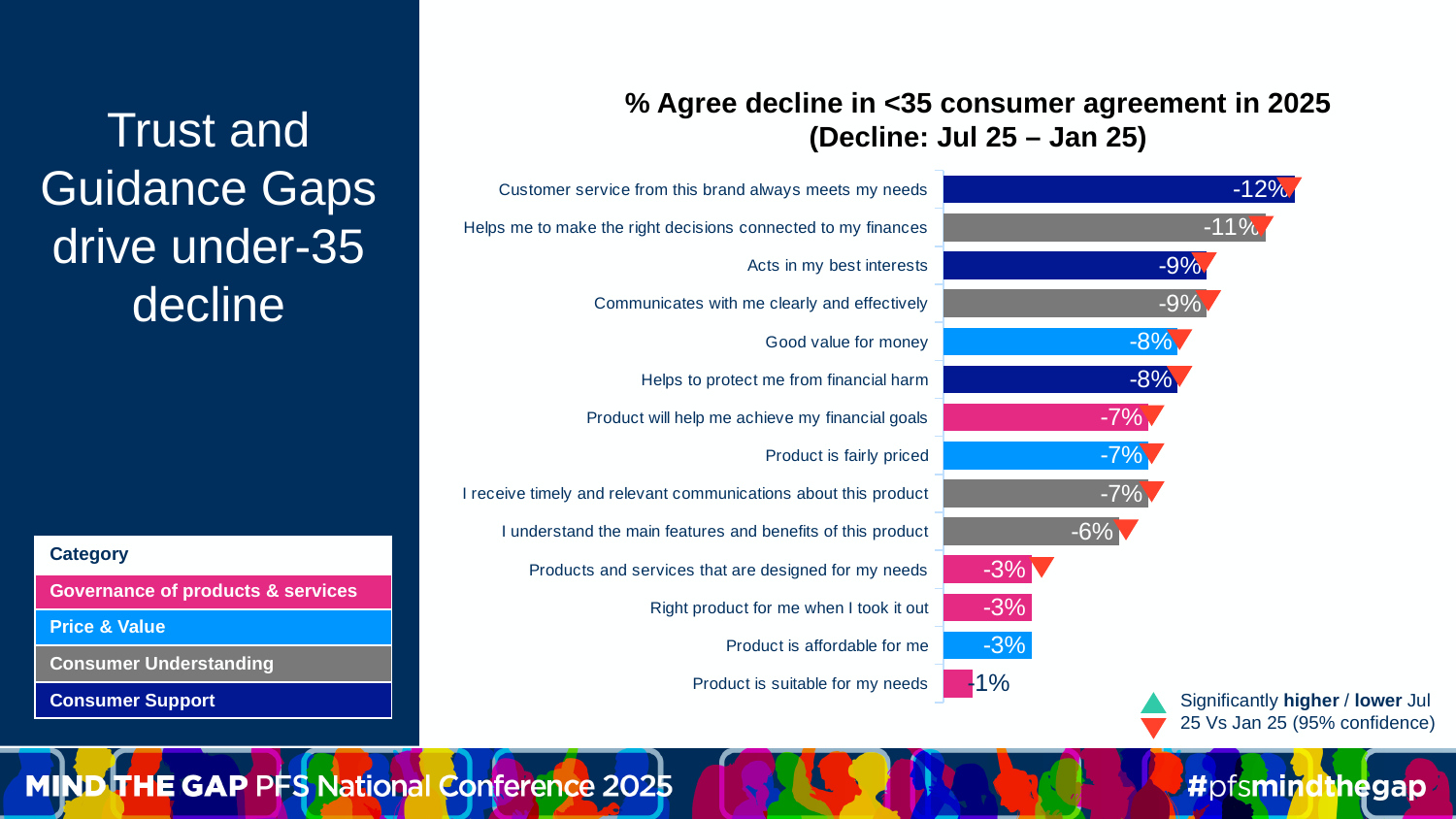
What is the difference between the values for "Customer service from this brand always meets my needs" and "Helps me to make the right decisions connected to my finances"? 1 percentage point Which statement shows the smallest decline? Product is suitable for my needs Which has the larger decline: "Acts in my best interests" or "Product is affordable for me"? Acts in my best interests How many categories does the Category legend list? 4 What is the value for "Customer service from this brand always meets my needs"? -12% What is the value for "Good value for money"? -8% What is the value for "I understand the main features and benefits of this product"? -6% Which statement shows the largest decline? Customer service from this brand always meets my needs What is the value for "Product is suitable for my needs"? -1% What kind of chart is shown on the slide? Bar chart How many statements are plotted in the chart? 14 What is the title of the chart? % Agree decline in <35 consumer agreement in 2025 (Decline: Jul 25 – Jan 25)